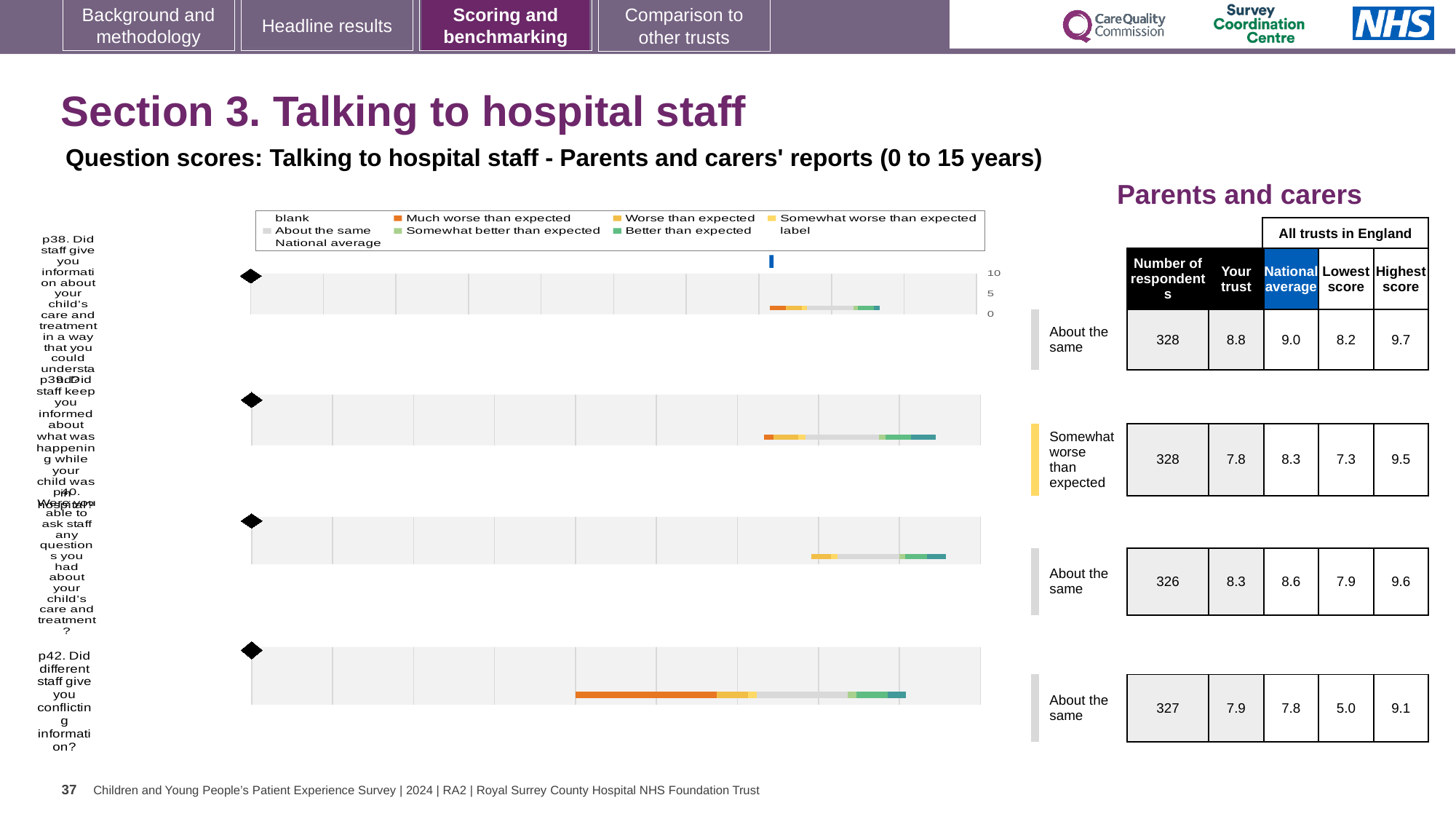
For p40 (Were you able to ask staff any questions you had about your child's care and treatment?), how many respondents are there? 326 Which question has the highest 'Your trust' score? p38 For p39 (Did staff keep you informed about what was happening while your child was in hospital?), what is the national average score? 8.3 For p38 (Did staff give you information about your child's care and treatment in a way that you could understand?), what is the 'Your trust' score? 8.8 Which question has the lowest 'Your trust' score? p39 What colour represents 'Much worse than expected' in the legend? orange For p38, what is the difference between the highest score and the lowest score among all trusts in England? 1.5 For p42, which is larger: the 'Your trust' score or the national average? Your trust How many survey questions (charts) are shown on the slide? 4 For p42 (Did different staff give you conflicting information?), what is the lowest score among all trusts in England? 5.0 What benchmark category is p39 rated as? Somewhat worse than expected What kind of chart is used to show the question scores on this slide? bar chart